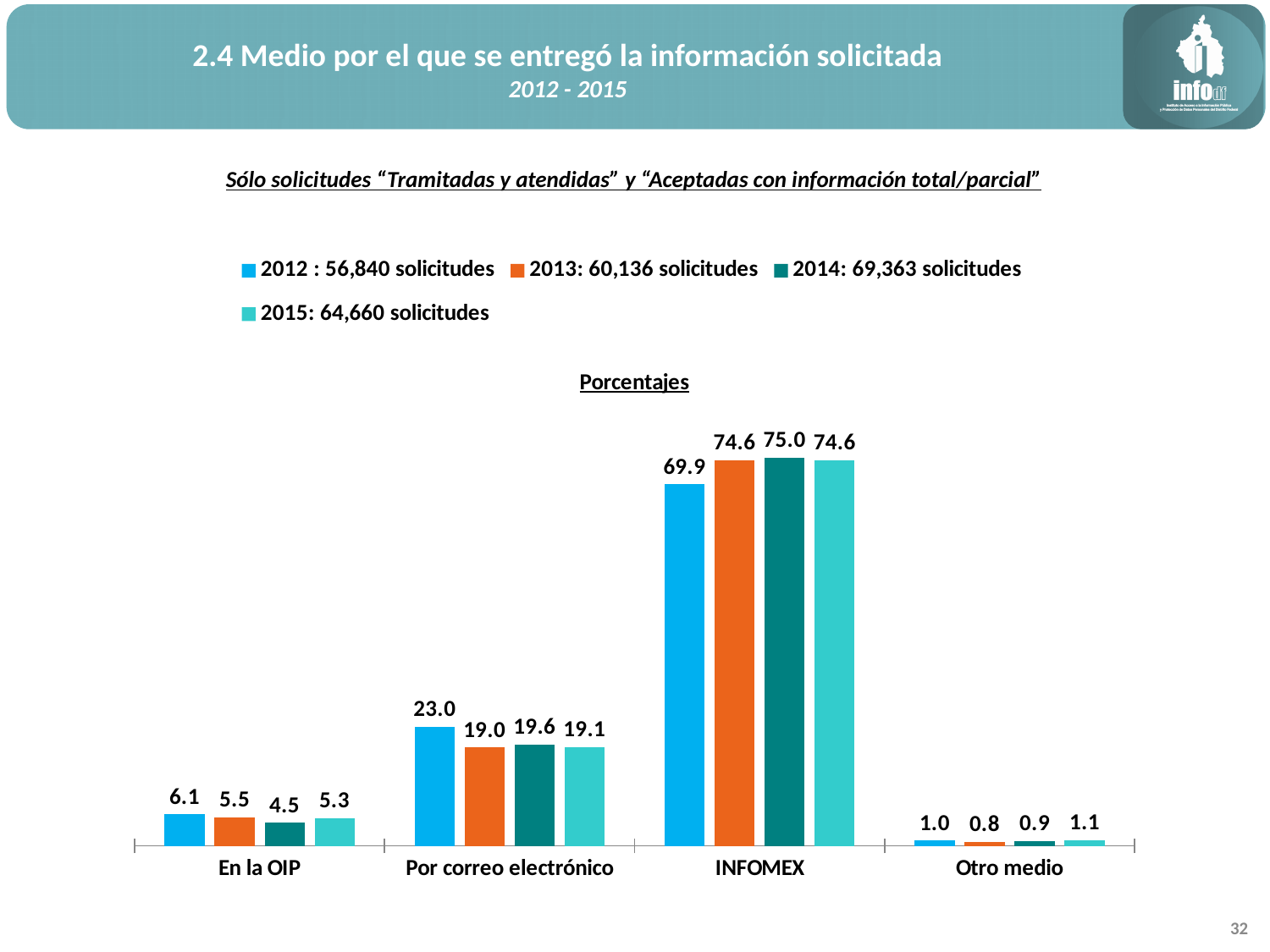
What is the value for Por correo electrónico in the 2015 series? 19.1 What is the value for En la OIP in the 2012 series? 6.1 Which category has the highest value in the 2012 series? INFOMEX How many series does the legend list? 4 How many categories are shown on the x axis? 4 What kind of chart is shown on the slide? Bar chart What is the value for Otro medio in the 2013 series? 0.8 What is the value for INFOMEX in the 2014 series? 75.0 Which is larger for En la OIP: the 2013 value or the 2014 value? 2013 What is the difference between the 2012 and 2013 values for Por correo electrónico? 4.0 According to the legend, how many solicitudes were there in 2014? 69,363 Which category has the lowest value in the 2015 series? Otro medio